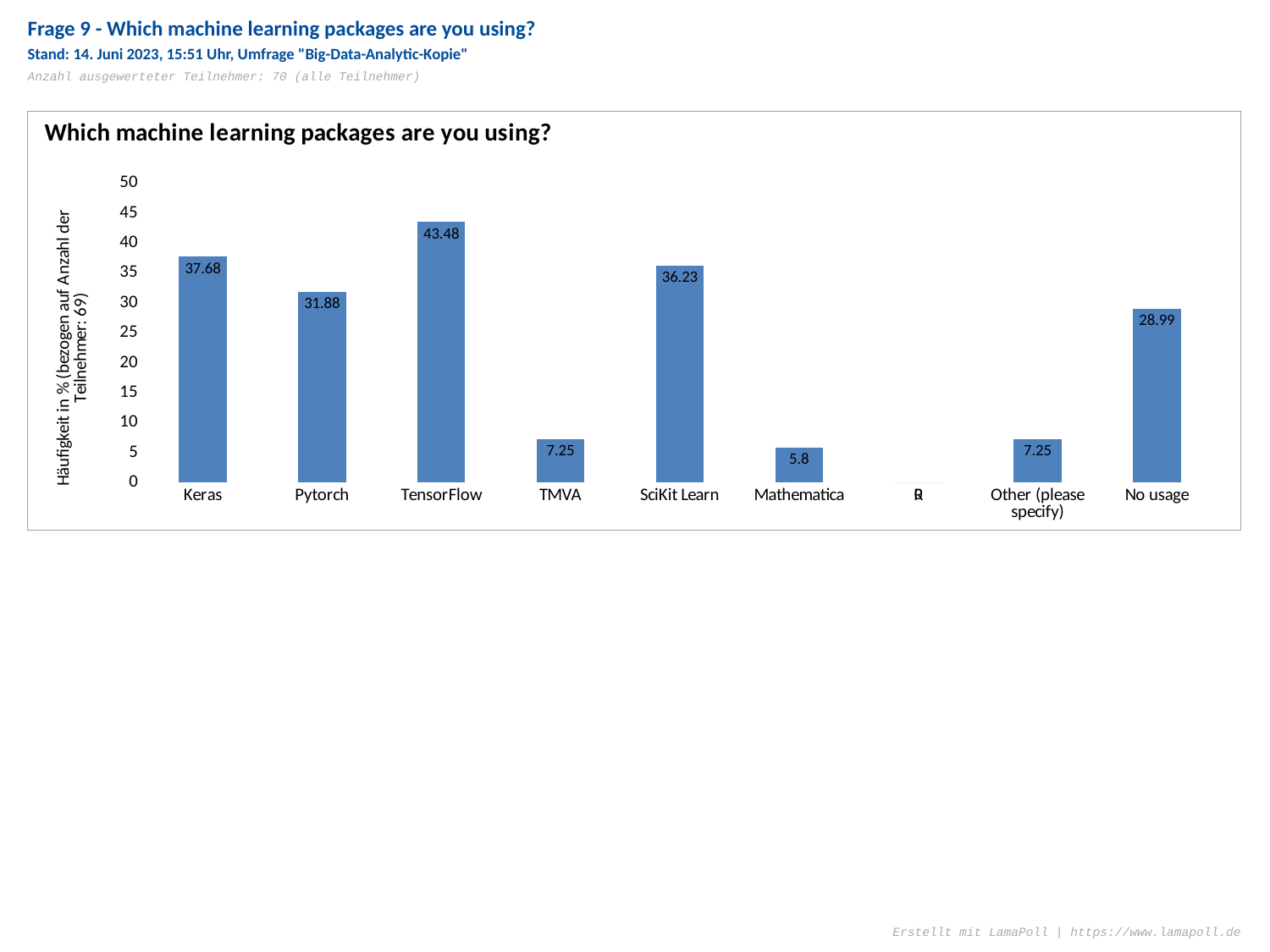
What is the difference between the values for SciKit Learn and Pytorch? 4.35 Is the value for Pytorch greater or less than 30? greater Which category has the highest value? TensorFlow Which is larger, the value for Keras or the value for SciKit Learn? Keras What is the value for Mathematica? 5.8 What is the title of the chart? Which machine learning packages are you using? Which is larger, the value for TMVA or the value for Mathematica? TMVA What is the difference between the values for TensorFlow and Keras? 5.8 What is the value for Keras? 37.68 What is the value for No usage? 28.99 What kind of chart is shown? bar chart What is the value for TensorFlow? 43.48